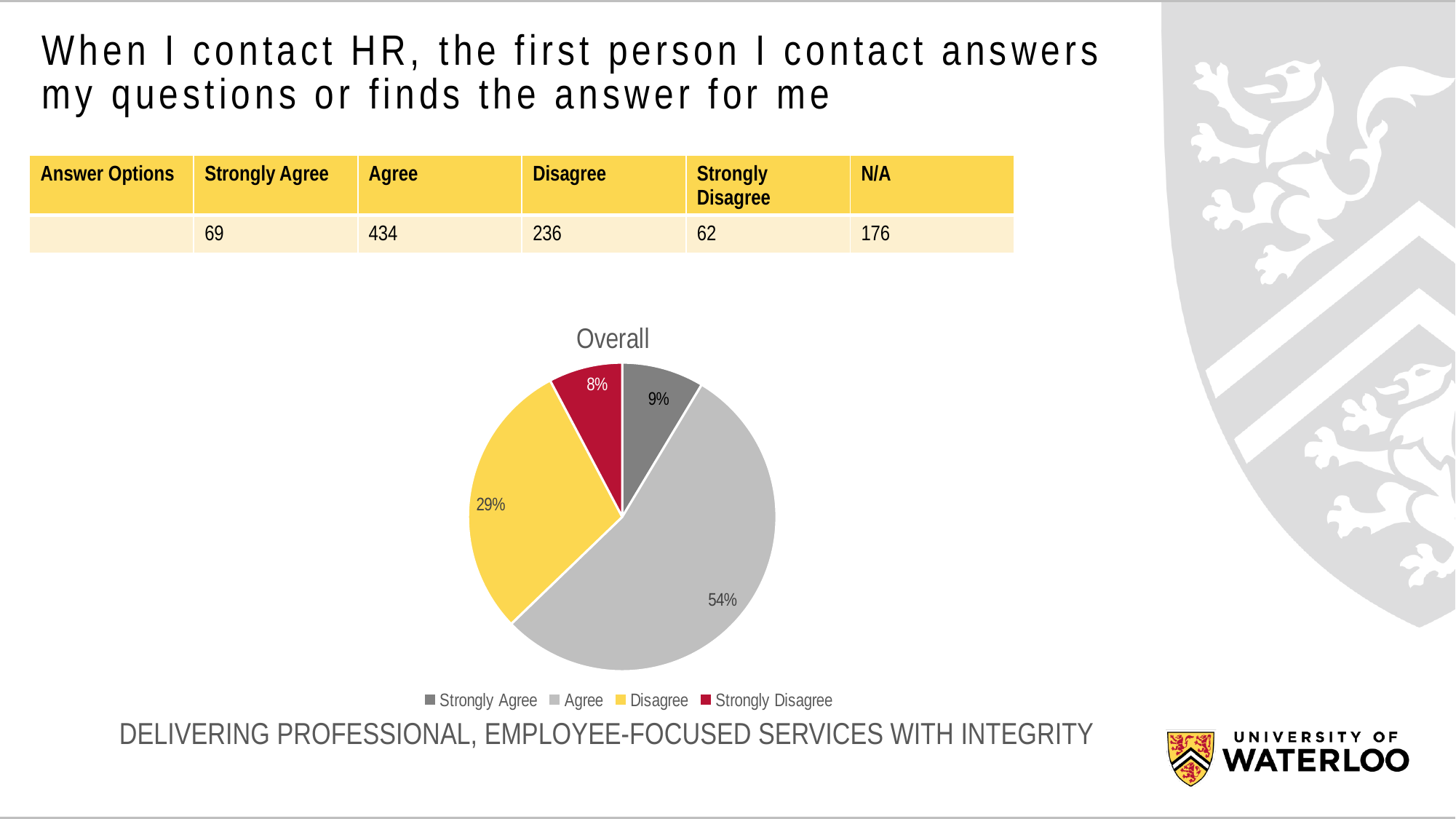
What is the difference in percentage points between the Agree and Disagree slices? 25 Which category has the largest slice of the pie? Agree What percentage of the pie does the Strongly Agree slice represent? 9% What kind of chart is shown on the slide? pie chart Which slice is larger, Disagree or Strongly Agree? Disagree What is the title of the pie chart? Overall What percentage of the pie does the Strongly Disagree slice represent? 8% How many categories does the legend of the pie chart list? 4 What percentage of the pie does the Agree slice represent? 54% Which category has the smallest slice of the pie? Strongly Disagree What colour is the Strongly Disagree slice in the pie chart? red What percentage of the pie does the Disagree slice represent? 29%